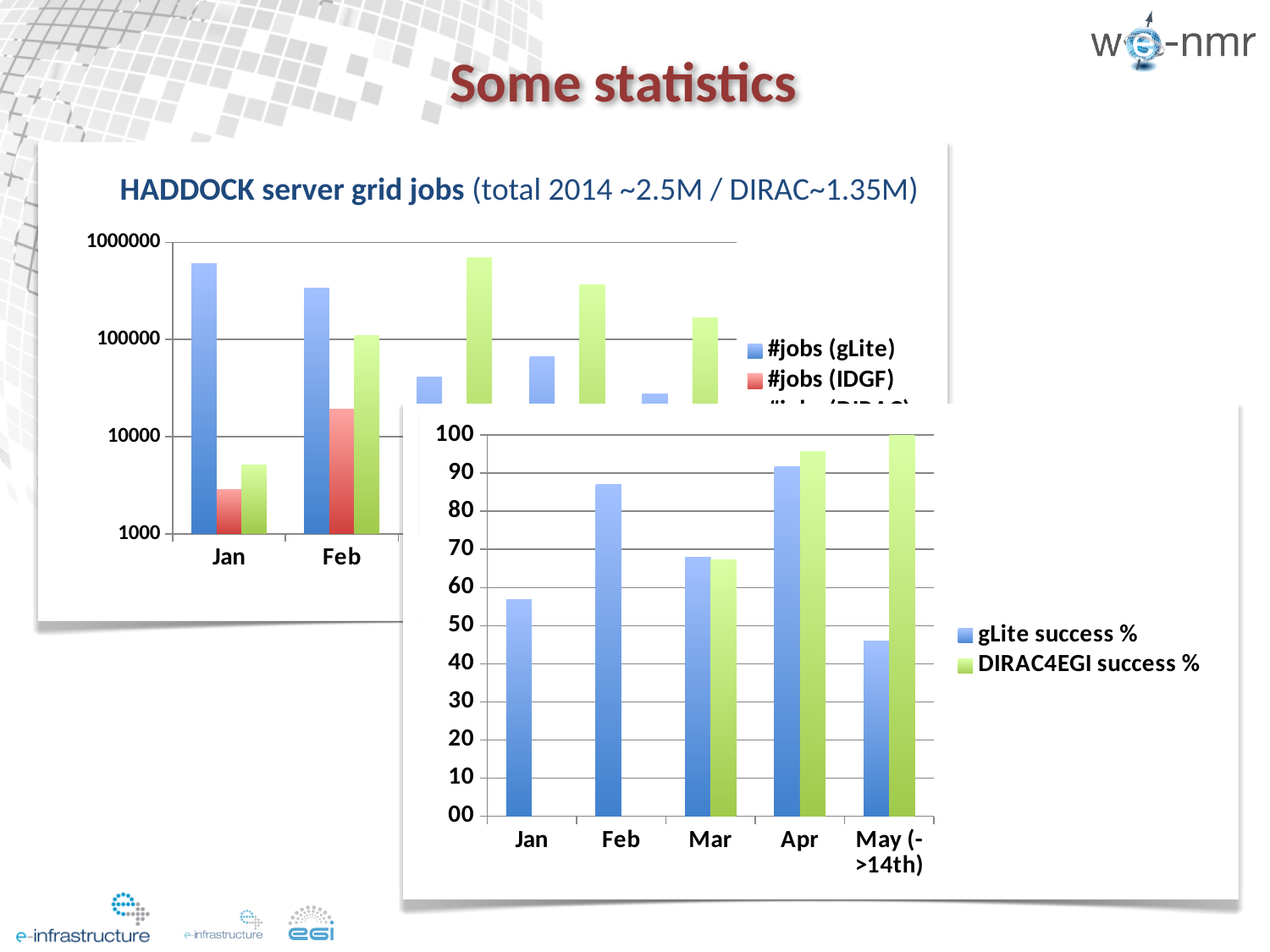
In the HADDOCK server grid jobs chart, which is larger in Feb: #jobs (gLite) or #jobs (IDGF)? #jobs (gLite) In the HADDOCK server grid jobs chart, is the #jobs (gLite) value for Feb greater or less than 100000? greater In the bottom-right success % chart, is the gLite success % for May (->14th) greater or less than 50? less How many series does the legend of the bottom-right success % chart list? 2 In the bottom-right success % chart, which month has the highest DIRAC4EGI success %? May (->14th) In the HADDOCK server grid jobs chart, is the #jobs (IDGF) value for Jan greater or less than 10000? less In the bottom-right success % chart, which month has the lowest gLite success %? May (->14th) What kind of chart is the bottom-right chart showing success percentages? bar chart In the HADDOCK server grid jobs chart, which series has the highest value in Jan? #jobs (gLite) How many months are shown on the x axis of the bottom-right success % chart? 5